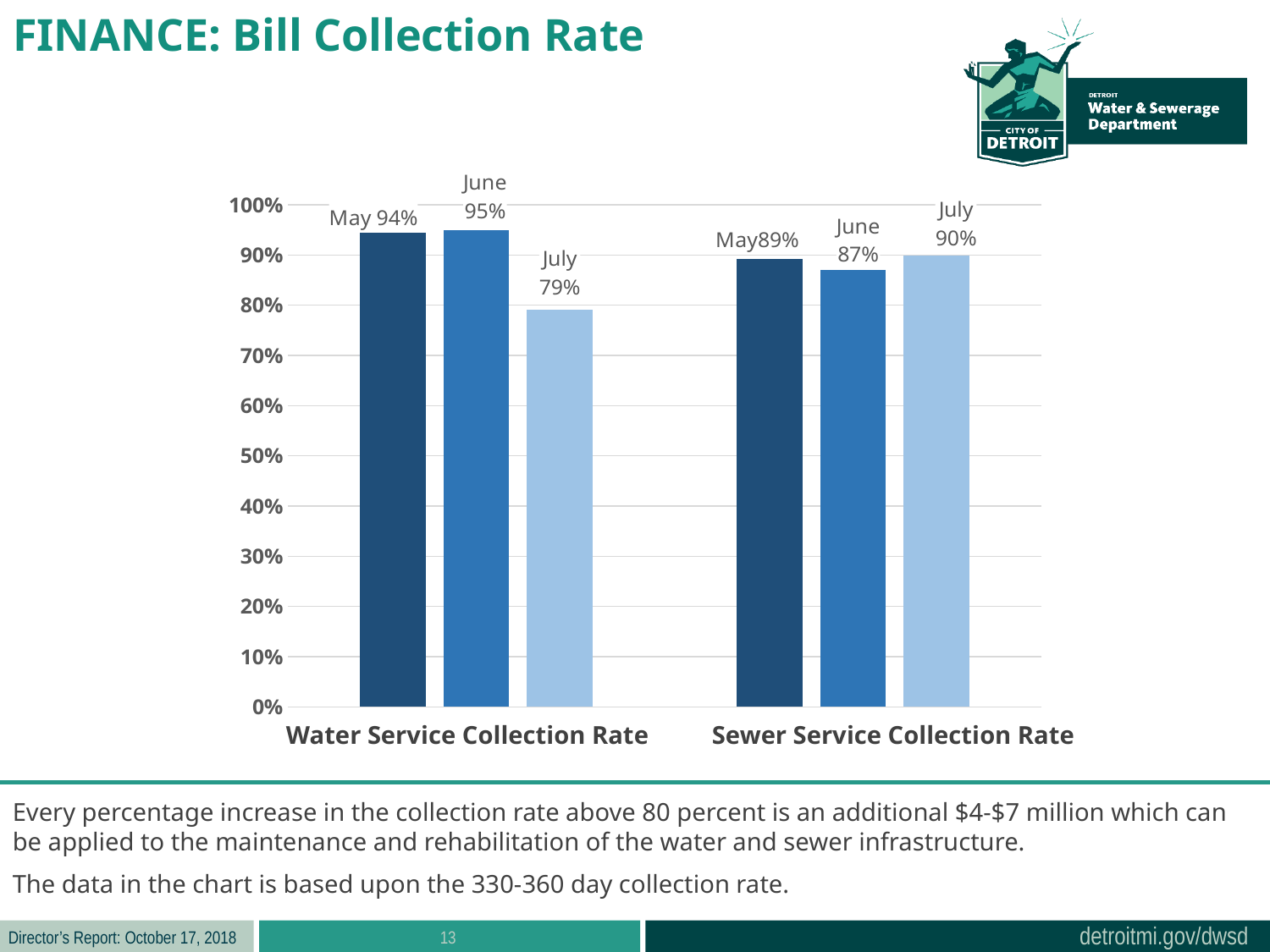
What kind of chart is shown on the slide? Bar chart What is the difference between the June and July Water Service Collection Rates? 16% What is the May Water Service Collection Rate? 94% Do the Sewer Service Collection Rate values rise or fall from June to July? Rise What is the July Sewer Service Collection Rate? 90% Which is larger, the July Water Service Collection Rate or the July Sewer Service Collection Rate? July Sewer Service Collection Rate What is the difference between the May Water Service Collection Rate and the May Sewer Service Collection Rate? 5% How many bars are plotted in the chart? 6 What is the June Sewer Service Collection Rate? 87% Which month has the lowest Water Service Collection Rate? July Is the July Water Service Collection Rate greater or less than 80%? less Which month has the highest Water Service Collection Rate? June